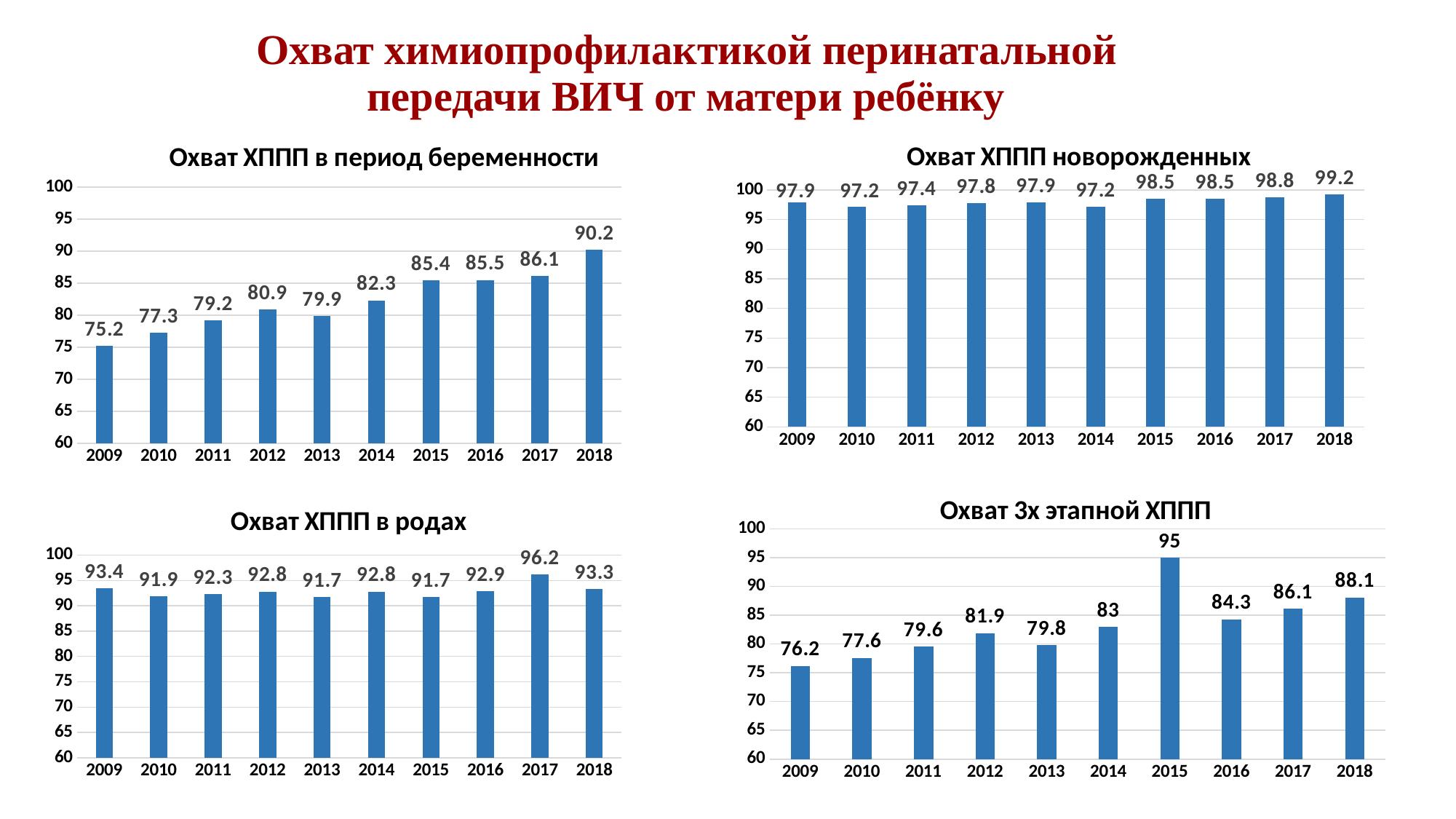
In the chart 'Охват ХППП в период беременности', what is the value for 2018? 90.2 In the chart 'Охват ХППП новорожденных', what is the value for 2014? 97.2 In the chart 'Охват ХППП в период беременности', which year has the lowest value? 2009 In the chart 'Охват ХППП в родах', which is larger, the value for 2009 or the value for 2010? 2009 How many years are shown on the x axis of the chart 'Охват 3х этапной ХППП'? 10 What type of chart is 'Охват ХППП в период беременности'? Bar chart In the chart 'Охват ХППП в родах', which year has the highest value? 2017 In the chart 'Охват 3х этапной ХППП', what is the difference between the values for 2015 and 2016? 10.7 In the chart 'Охват ХППП новорожденных', which year has the highest value? 2018 In the chart 'Охват 3х этапной ХППП', what is the value for 2015? 95 How many charts are shown on the slide? 4 In the chart 'Охват ХППП в период беременности', what is the difference between the values for 2018 and 2009? 15